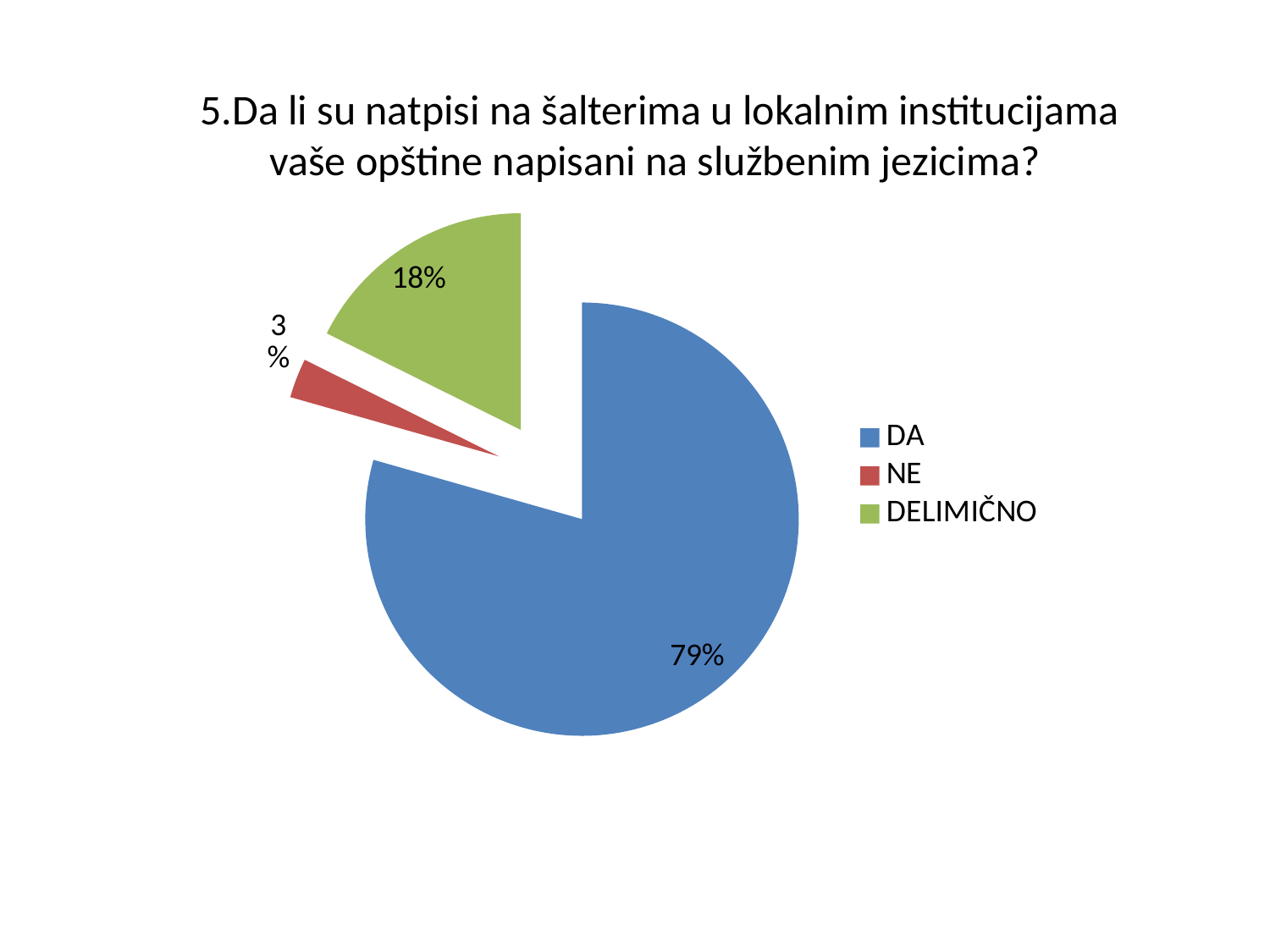
What is the title of the chart? 5.Da li su natpisi na šalterima u lokalnim institucijama vaše opštine napisani na službenim jezicima? What share of the pie does NE represent? 3% What is the difference in percentage points between DELIMIČNO and NE? 15 What colour is the slice for DELIMIČNO? Green How many categories does the pie chart show? 3 What share of the pie does DELIMIČNO represent? 18% Which category has the largest slice of the pie? DA What kind of chart is shown on the slide? Pie chart What is the difference in percentage points between DA and DELIMIČNO? 61 Which category has the smallest slice of the pie? NE What share of the pie does DA represent? 79% Which is larger, the share for NE or the share for DELIMIČNO? DELIMIČNO